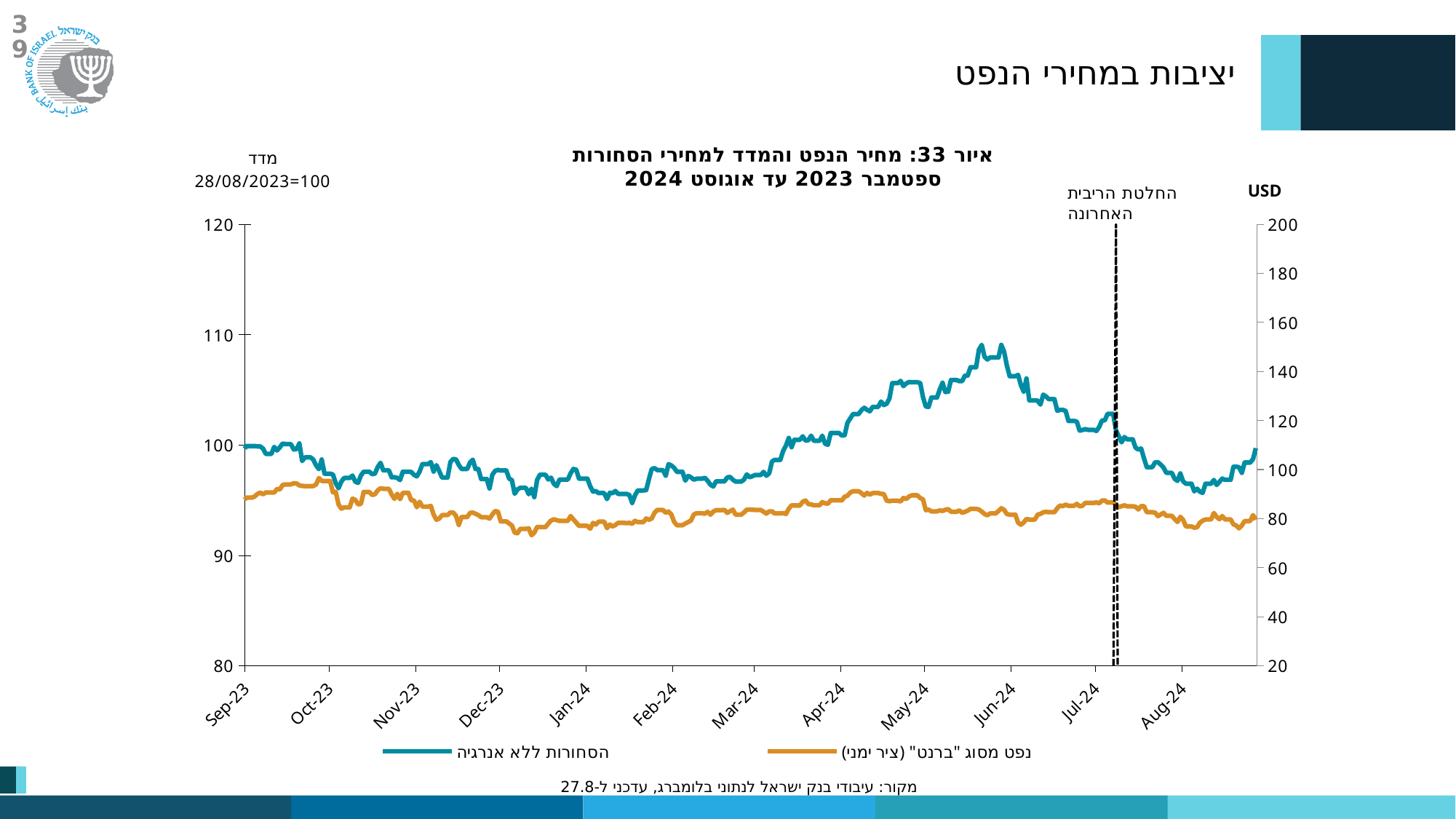
Which series is plotted on the right axis in USD? נפט מסוג "ברנט" What is the base date of the index shown on the left axis? 28/08/2023=100 How many series does the legend list? 2 Does the non-energy commodities index (הסחורות ללא אנרגיה) rise or fall between Jun-24 and Aug-24? fall Is the value of the non-energy commodities index (הסחורות ללא אנרגיה) at its peak around Jun-24 greater or less than 105? greater How many month labels are shown on the x axis? 12 Does the non-energy commodities index (הסחורות ללא אנרגיה) rise or fall between Mar-24 and Jun-24? rise What is the title of the chart? איור 33: מחיר הנפט והמדד למחירי הסחורות ספטמבר 2023 עד אוגוסט 2024 Is the value of the non-energy commodities index (הסחורות ללא אנרגיה) at Aug-24 greater or less than 100? less What kind of chart is shown on the slide? line chart Is the value of the non-energy commodities index (הסחורות ללא אנרגיה) at Jul-24 greater or less than 100? greater